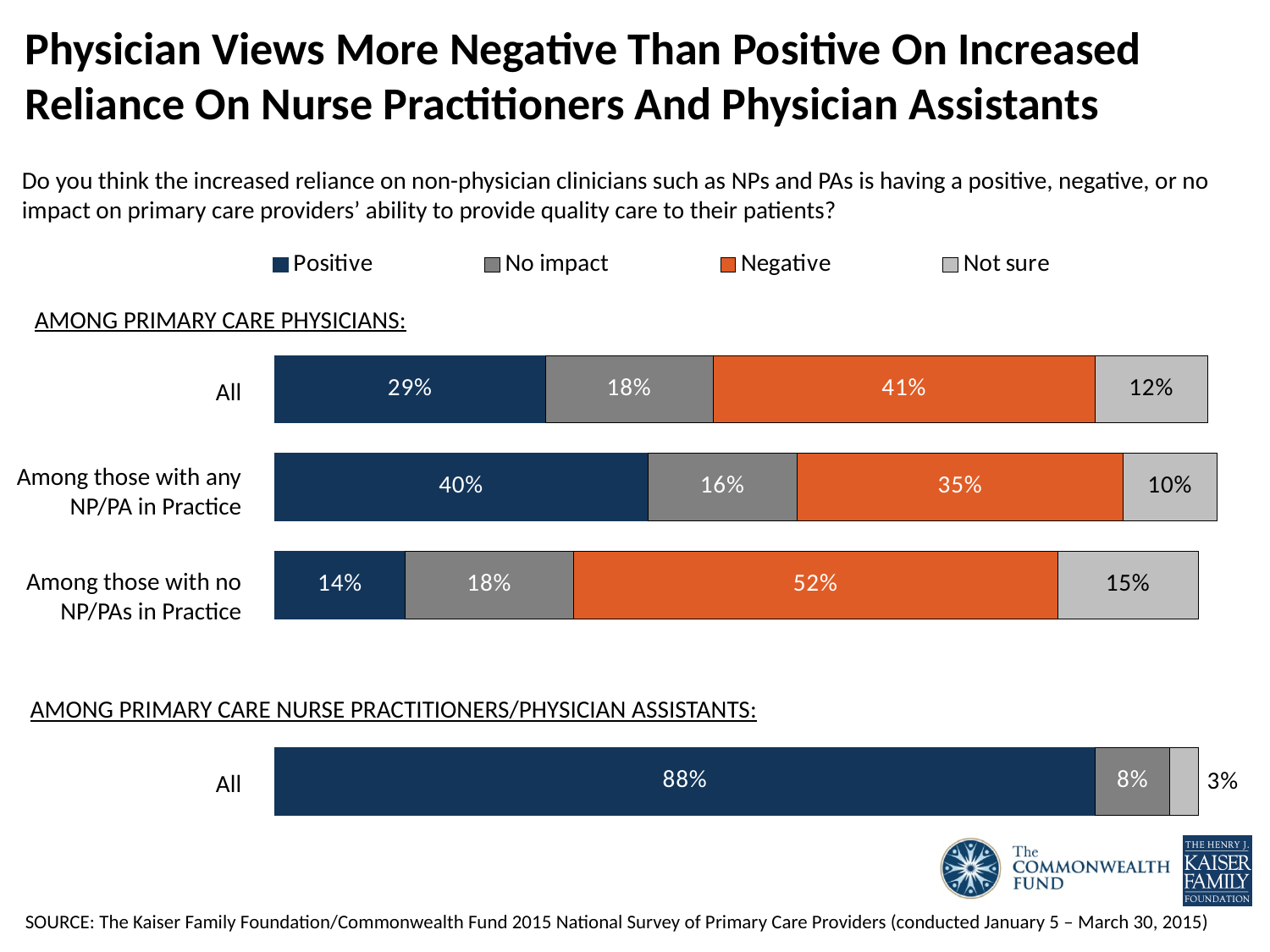
In the chart among primary care physicians, what percentage of those with any NP/PA in practice said the impact is positive? 40% In the chart among primary care physicians, is the Positive percentage larger for those with any NP/PA in practice or for those with no NP/PAs in practice? Among those with any NP/PA in Practice In the chart among primary care physicians, what is the difference between the Negative and Positive percentages for all physicians? 12 percentage points In the chart among primary care physicians, what is the Not sure percentage for those with no NP/PAs in practice? 15% In the chart among primary care physicians, what percentage of those with no NP/PAs in practice said the impact is negative? 52% How many groups (bars) are shown in the chart among primary care physicians? 3 In the chart among primary care physicians, which group has the lowest Positive percentage? Among those with no NP/PAs in Practice What kind of chart is used on this slide? Stacked bar chart In the chart among primary care physicians, what percentage of all physicians said the increased reliance has a negative impact? 41% How many series does the legend list? 4 In the chart among primary care nurse practitioners/physician assistants, what percentage said the impact is positive? 88% In the chart among primary care physicians, which group has the highest Negative percentage? Among those with no NP/PAs in Practice